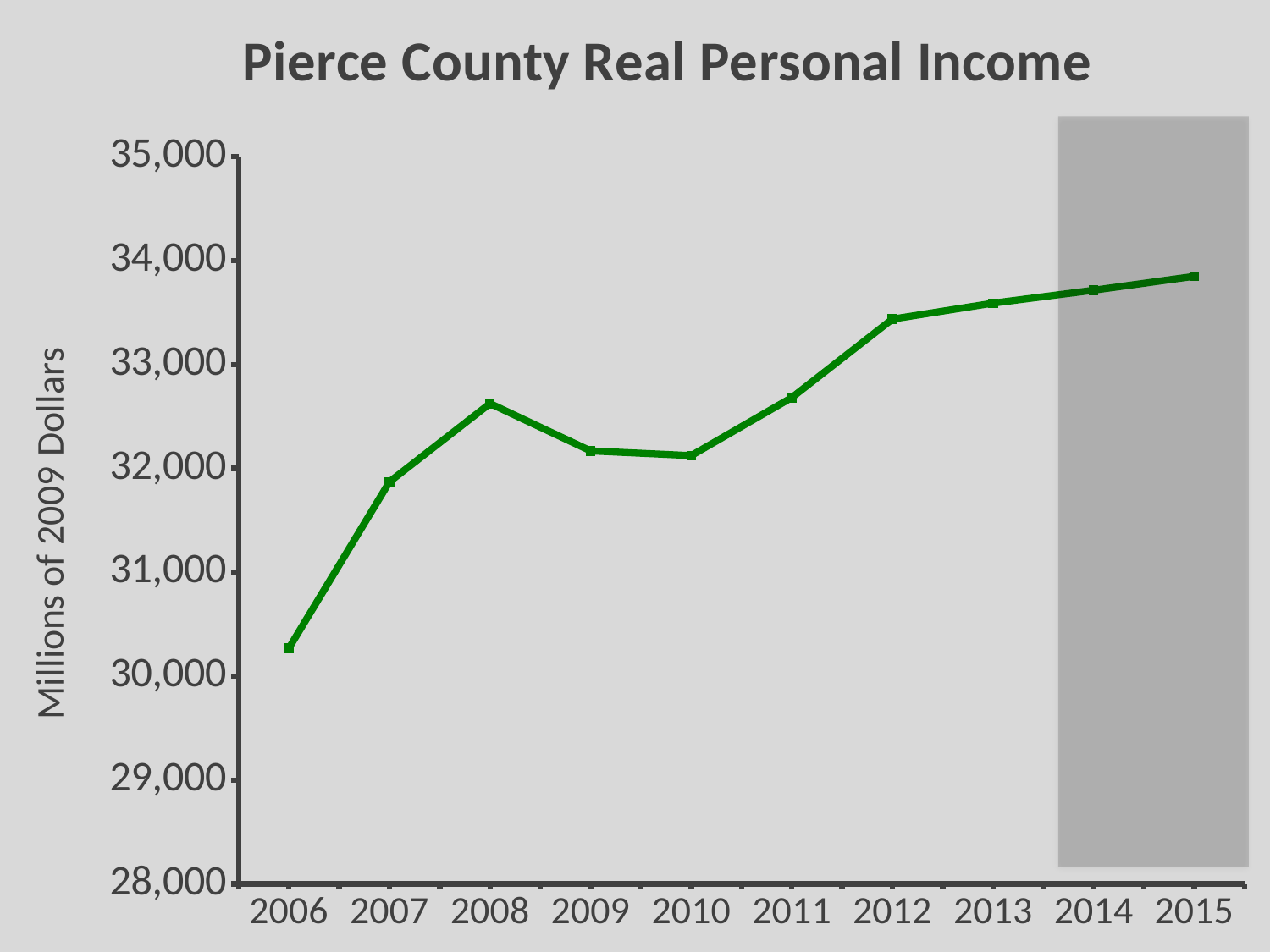
How many years are plotted on the x axis? 10 What is the label on the vertical axis? Millions of 2009 Dollars Which year has the lowest real personal income? 2006 Does real personal income rise or fall overall from 2006 to 2015? rise What kind of chart is shown on the slide? line chart Is the value for 2012 greater or less than 33,000? greater Is the value for 2007 greater or less than 32,000? less Is the value for 2006 greater or less than 31,000? less Which year has the highest real personal income? 2015 What is the title of the chart? Pierce County Real Personal Income Which year has the higher value, 2008 or 2009? 2008